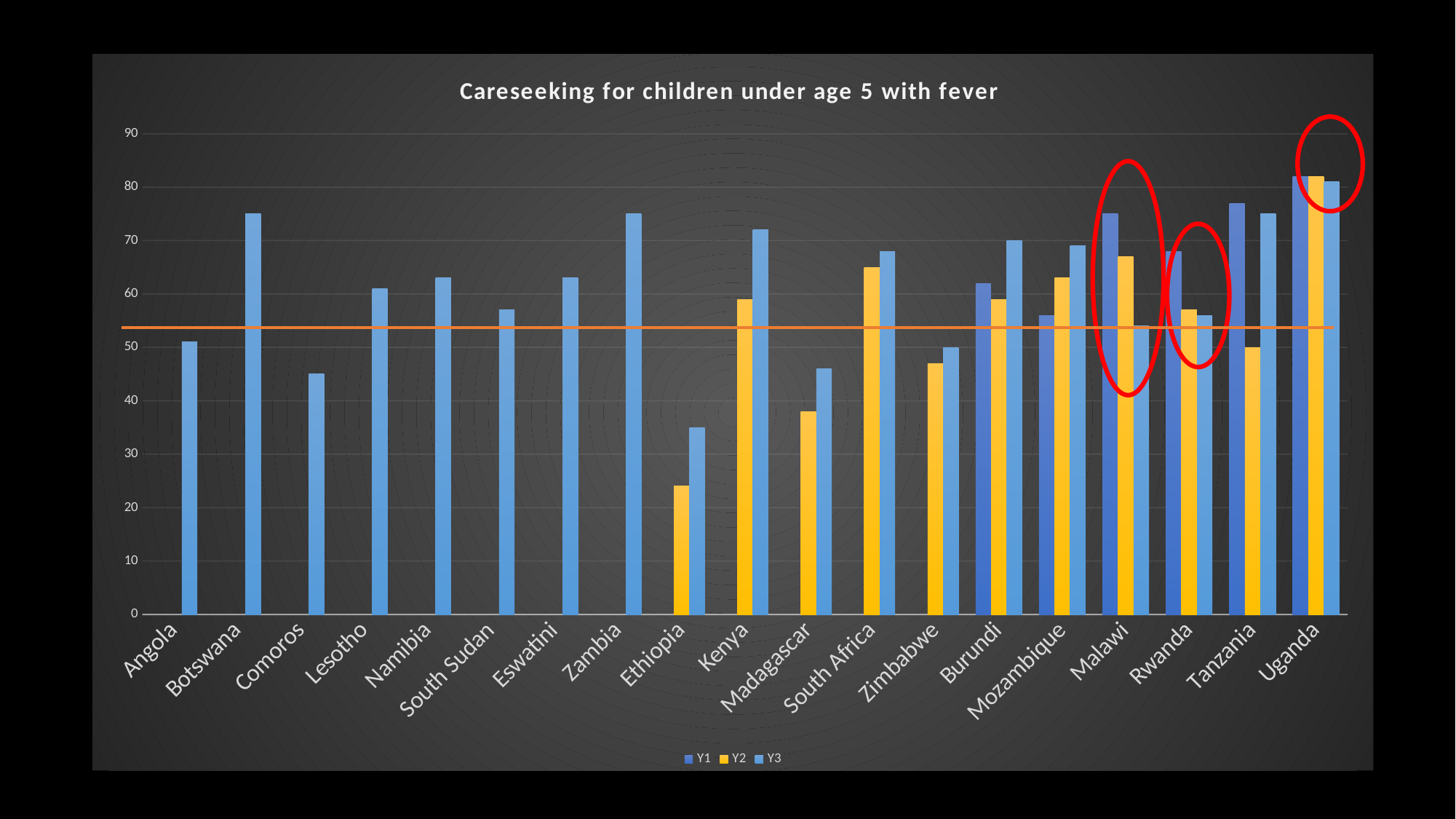
Is the Y3 value for Botswana greater or less than 70? greater What is the title of the chart? Careseeking for children under age 5 with fever Is the Y3 value for Comoros greater or less than 50? less For Kenya, which is larger, the Y2 value or the Y3 value? Y3 For Tanzania, which is larger, the Y1 value or the Y2 value? Y1 Which country has the highest Y3 value? Uganda What kind of chart is shown on the slide? bar chart Which country has the lowest Y2 value? Ethiopia How many series does the legend list? 3 Is the Y2 value for Ethiopia greater or less than 30? less Which country has the lowest Y3 value? Ethiopia How many countries are shown on the x axis? 19